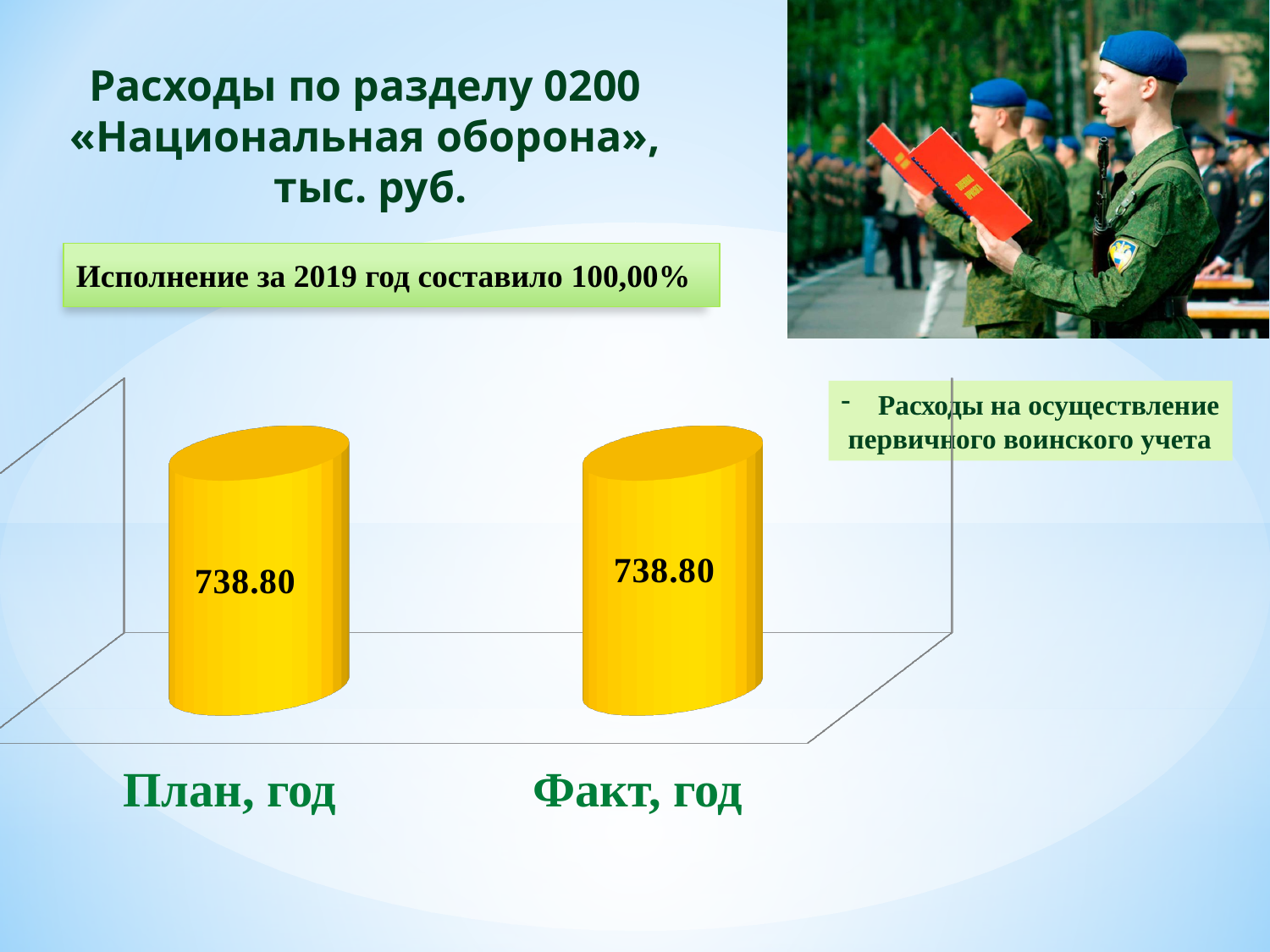
What colour are the bars on the chart? yellow What is the difference between the values for «План, год» and «Факт, год»? 0.00 What is the total of the values for «План, год» and «Факт, год»? 1477.60 What is the value for «Факт, год»? 738.80 Is the value for «Факт, год» equal to the value for «План, год»? yes What is the value for «План, год»? 738.80 What is the title of the chart on the slide? Расходы по разделу 0200 «Национальная оборона», тыс. руб. What kind of chart is shown on the slide? bar chart How many categories are shown on the chart? 2